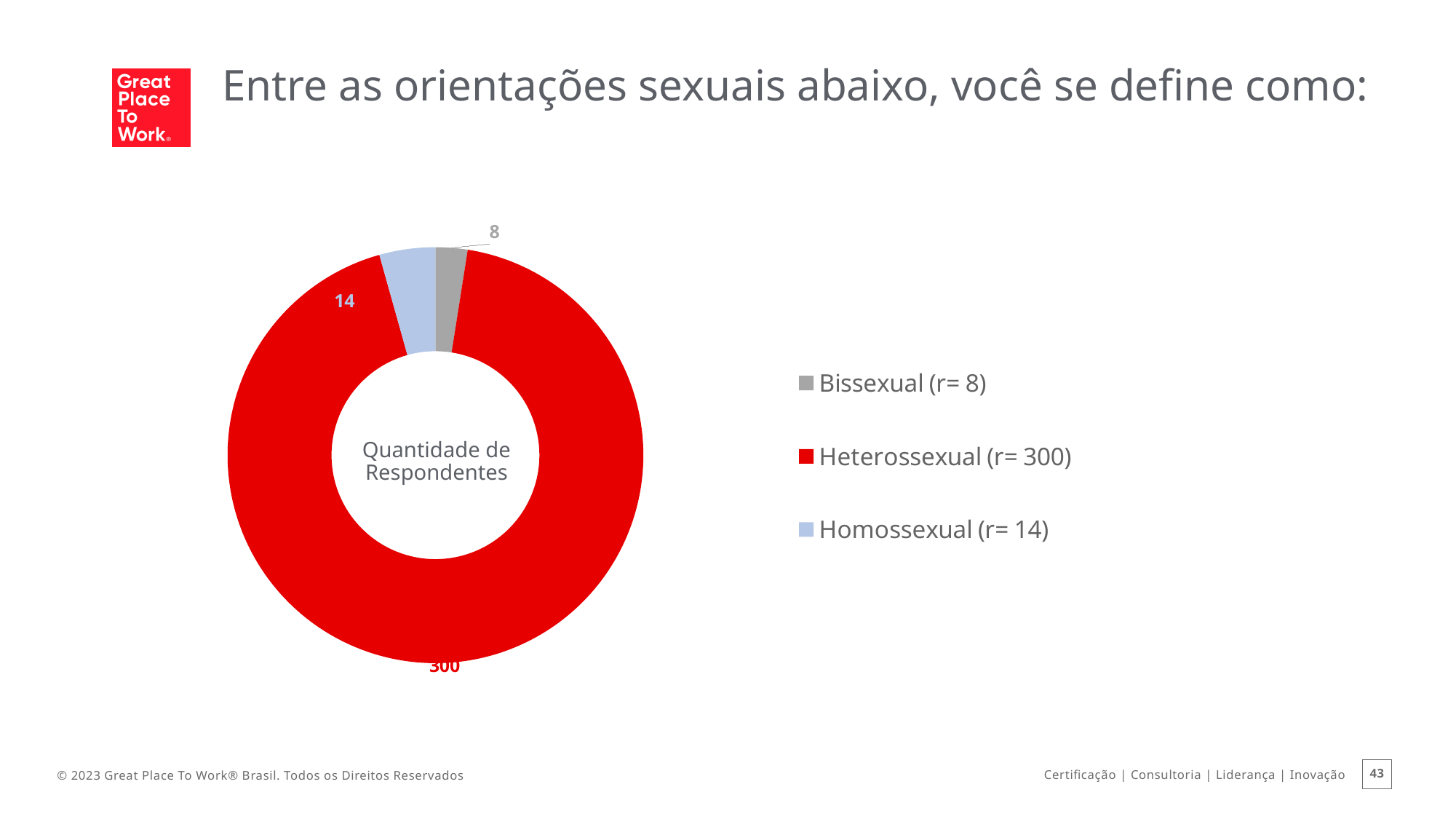
What is the difference between the number of Homossexual and Bissexual respondents? 6 How many respondents identified as Heterossexual? 300 Which has more respondents, Homossexual or Bissexual? Homossexual What text is shown in the centre of the doughnut chart? Quantidade de Respondentes What is the total number of respondents across all categories? 322 What type of chart is shown on the slide? Doughnut (pie) chart Which category has the largest number of respondents? Heterossexual How many respondents identified as Homossexual? 14 What is the difference between the number of Heterossexual and Homossexual respondents? 286 How many respondents identified as Bissexual? 8 How many categories does the chart show? 3 Which category has the smallest number of respondents? Bissexual